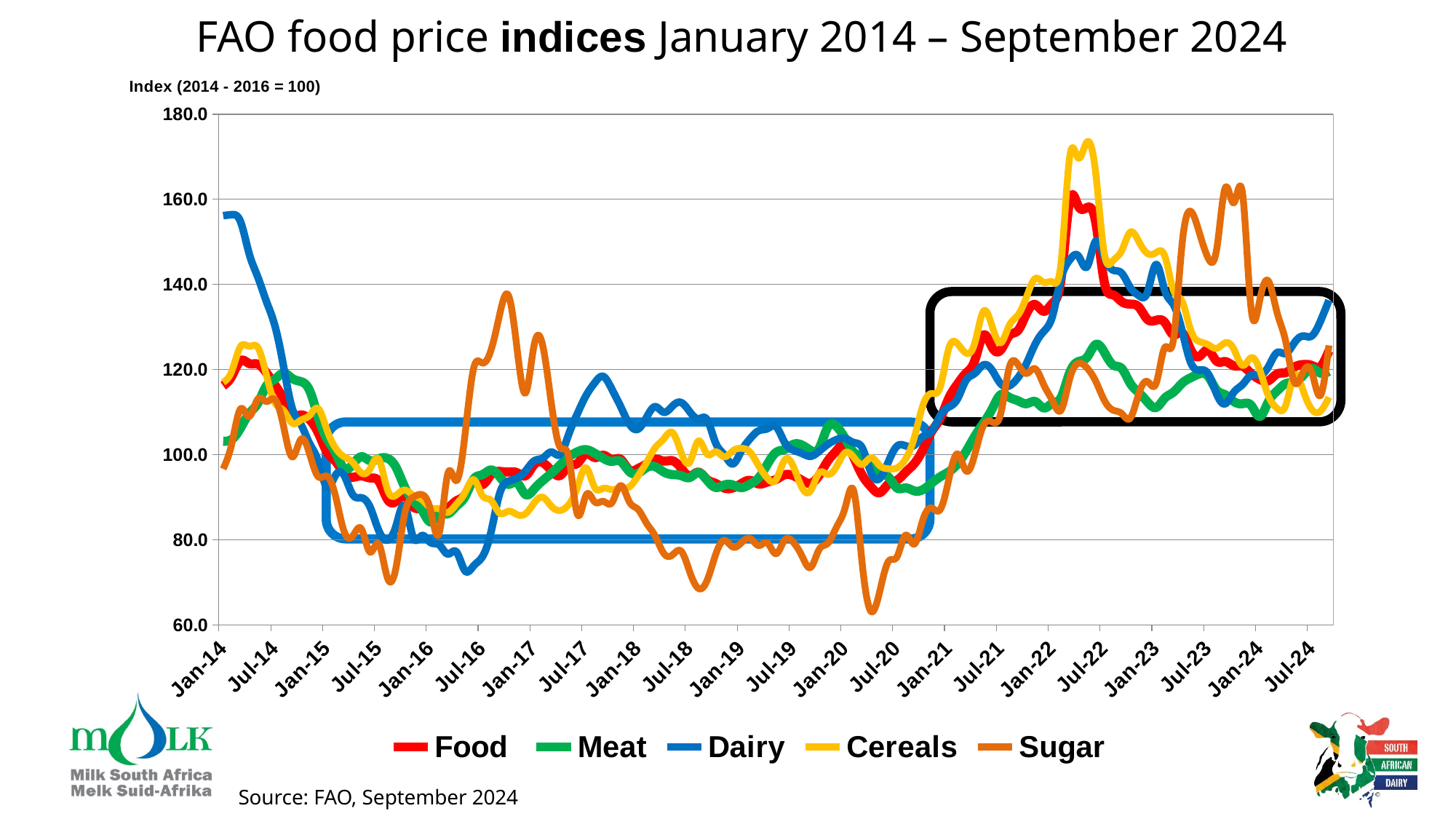
What label is shown on the vertical axis of the chart? Index (2014 - 2016 = 100) At Jan-14, which is larger, the Dairy index or the Sugar index? Dairy What kind of chart is shown on the slide? Line chart Which series reaches the lowest value anywhere on the chart? Sugar Is the peak of the Cereals line in 2022 greater or less than 160? greater Is the Sugar index value at Jan-14 greater or less than 100? less Does the Dairy index rise or fall between Jan-14 and Jan-15? Fall What is the title of the chart? FAO food price indices January 2014 – September 2024 Which series reaches the highest value anywhere on the chart? Cereals Is the Dairy index value at Jan-14 greater or less than 140? greater How many series does the legend list? 5